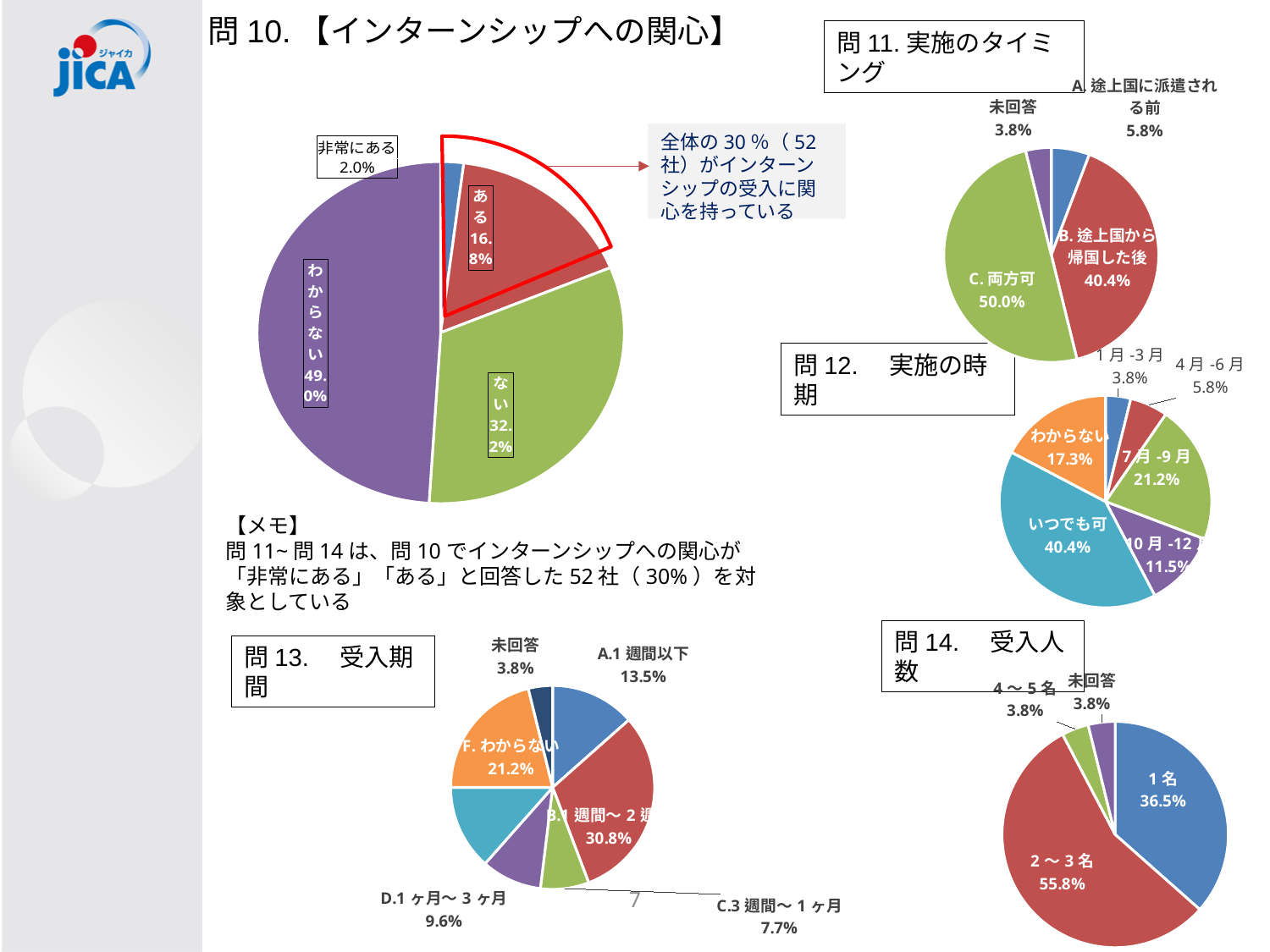
In the 問13 受入期間 chart, what percentage is shown for B.1週間～2週間? 30.8% In the 問14 受入人数 chart, what percentage is shown for 2～3名? 55.8% In the 問10 【インターンシップへの関心】 chart, what percentage is shown for わからない? 49.0% In the 問11 実施のタイミング chart, what percentage is shown for C. 両方可? 50.0% How many slices does the 問12 実施の時期 pie chart have? 6 In the 問12 実施の時期 chart, which category has the largest share? いつでも可 In the 問10 【インターンシップへの関心】 chart, what is the difference between the shares for ない and ある? 15.4% In the 問13 受入期間 chart, what is the difference between F. わからない and D.1ヶ月～3ヶ月? 11.6% In the 問10 【インターンシップへの関心】 chart, which category has the smallest share? 非常にある In the 問12 実施の時期 chart, what percentage is shown for 7月-9月? 21.2% What type of chart is used for 問14 受入人数? Pie chart In the 問11 実施のタイミング chart, which is larger, A. 途上国に派遣される前 or B. 途上国から帰国した後? B. 途上国から帰国した後